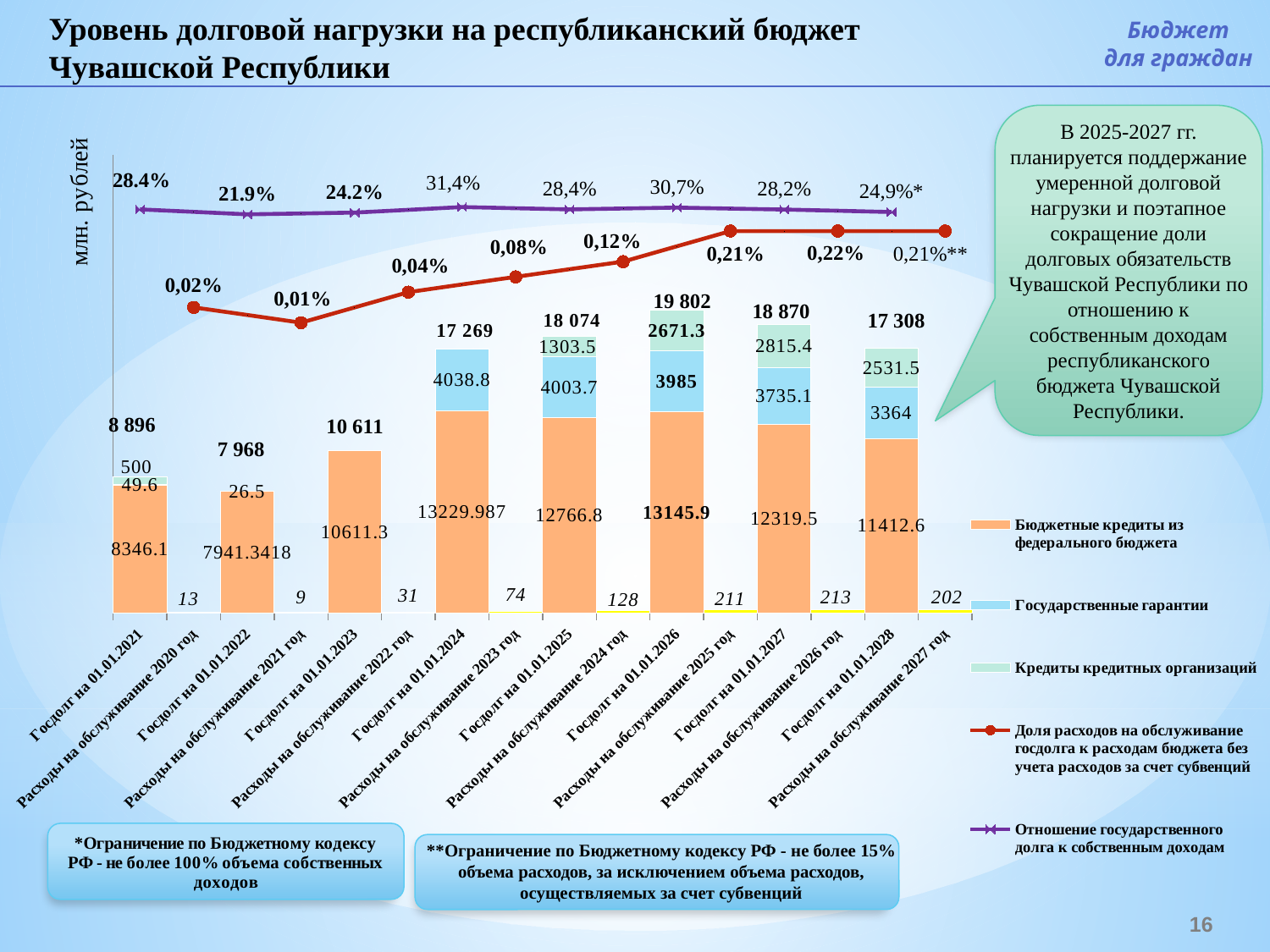
Which date has the lowest total state debt (Госдолг) bar? Госдолг на 01.01.2022 Which is larger: state guarantees (Государственные гарантии) on 01.01.2024 or on 01.01.2025? 01.01.2024 How many series does the legend list? 5 What is the total state debt (Госдолг) shown for 01.01.2026? 19 802 What is the value of loans from credit organisations (Кредиты кредитных организаций) for Госдолг на 01.01.2027? 2815.4 What is the ratio of state debt to own revenues (Отношение государственного долга к собственным доходам) for 01.01.2024? 31,4% What is the share of debt servicing expenses (Доля расходов на обслуживание госдолга) for 2026? 0,22% What is the difference between the total state debt on 01.01.2026 (19 802) and on 01.01.2027 (18 870)? 932 What is the value of debt servicing expenses (Расходы на обслуживание) for 2025? 211 Which date has the highest total state debt (Госдолг) bar? Госдолг на 01.01.2026 What is the value of budget credits from the federal budget (Бюджетные кредиты из федерального бюджета) for Госдолг на 01.01.2024? 13229.987 What is the lowest value on the line for the share of debt servicing expenses (Доля расходов на обслуживание госдолга)? 0,01%